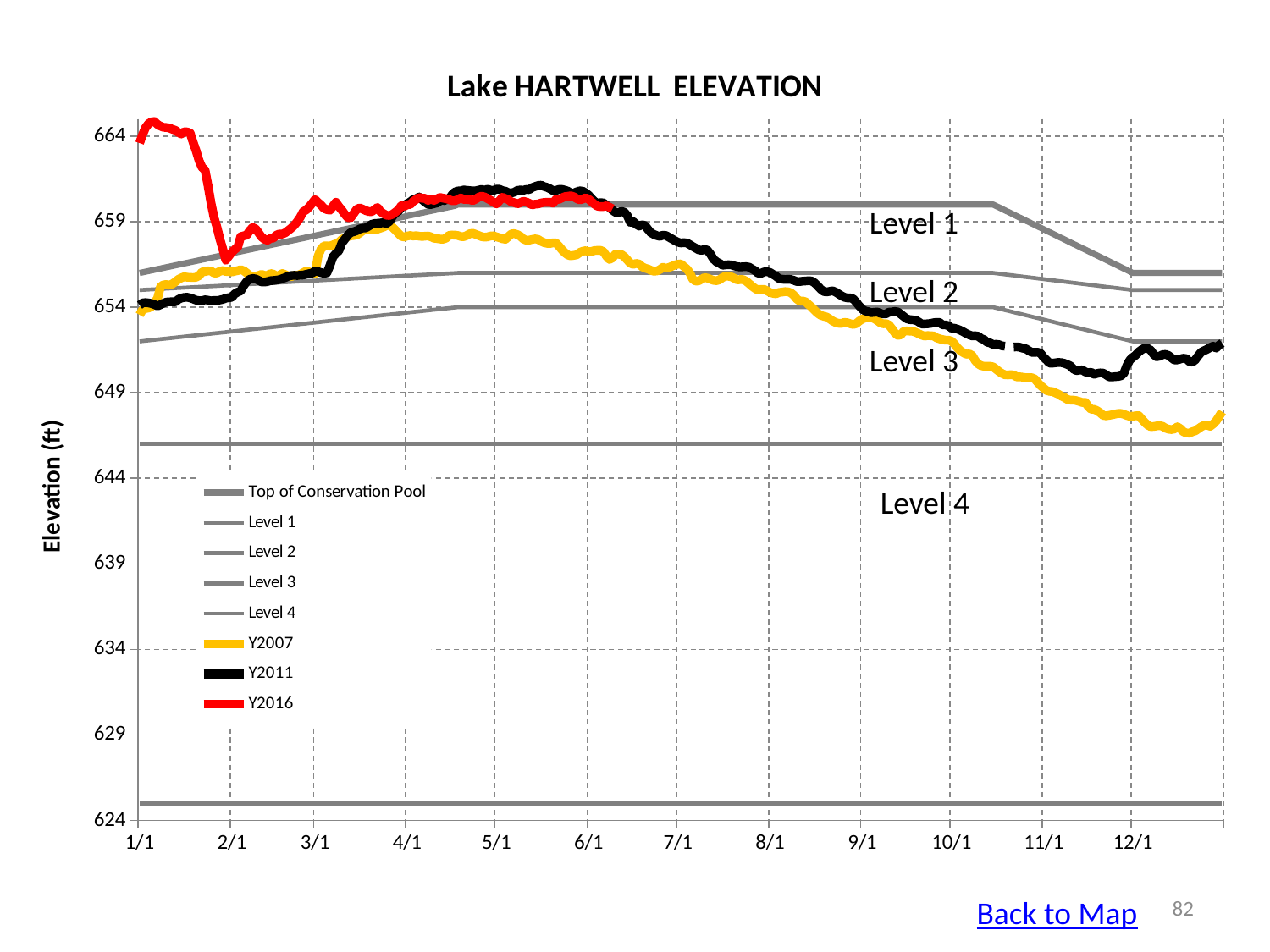
Is the value for Y2011 at 12/1 greater or less than 654? less Does the Y2011 series rise or fall between 1/1 and 5/1? rise What kind of chart is shown on the slide? line chart What is the title of the chart? Lake HARTWELL ELEVATION Which series is drawn in red? Y2016 Does the Y2007 series rise or fall between 6/1 and 12/1? fall Is the value for Y2011 at 5/1 greater or less than 659? greater At 12/1, which series has the higher elevation, Y2011 or Y2007? Y2011 Is the value for Y2016 at 1/1 greater or less than 659? greater How many series does the legend list? 8 At 1/1, which series has the higher elevation, Y2016 or Y2007? Y2016